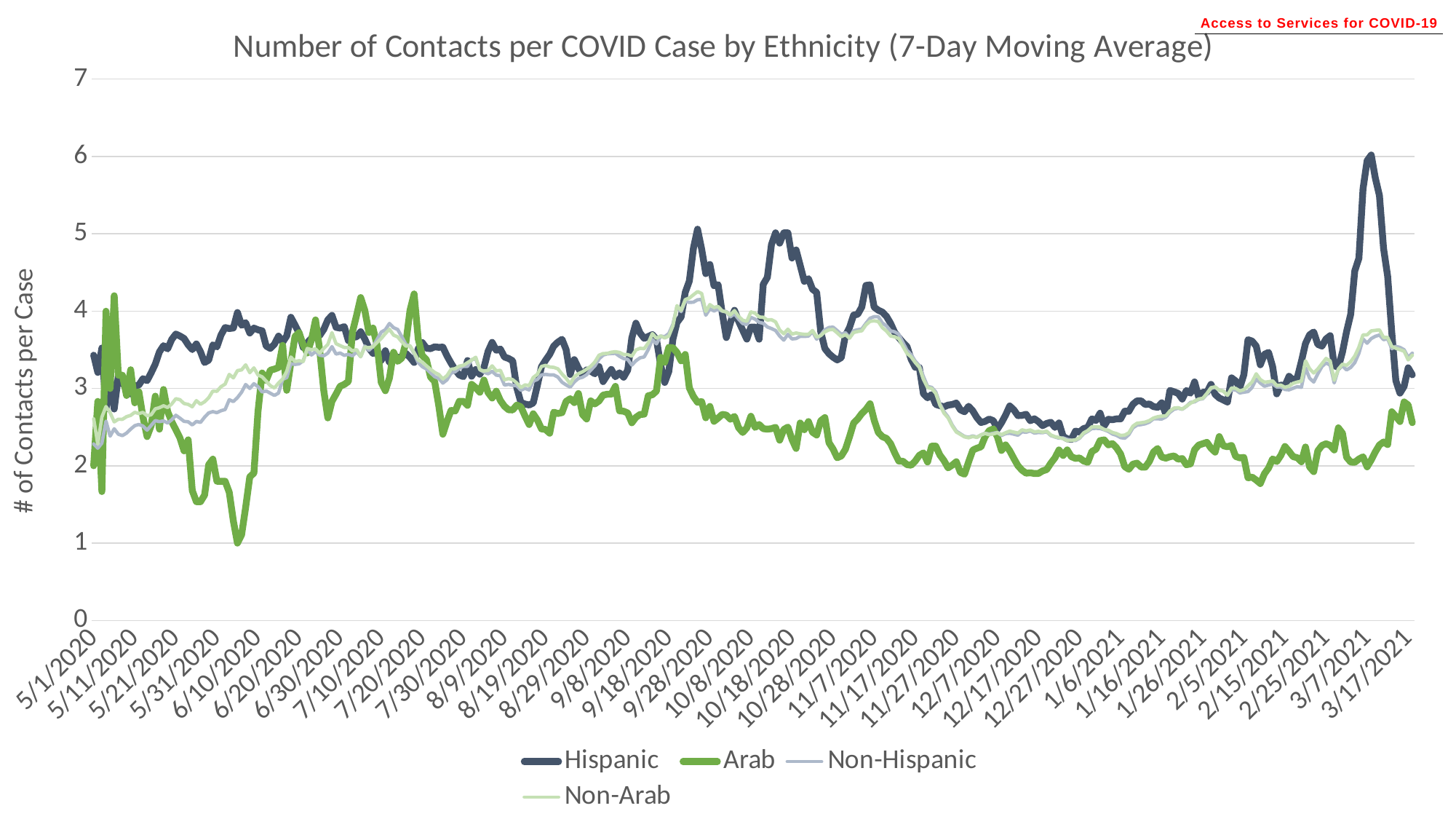
Is the lowest value of the Arab line around 6/10/2020 greater or less than 2? less What kind of chart is shown on the slide? Line chart What is the label on the vertical axis? # of Contacts per Case Does the Arab line generally rise or fall between 9/18/2020 and 12/17/2020? fall Which series has the lowest value around 12/17/2020? Arab Is the value of the Arab line around 12/17/2020 greater or less than 3? less How many series does the legend list? 4 What is the title of the chart? Number of Contacts per COVID Case by Ethnicity (7-Day Moving Average) Is the peak value of the Hispanic line around 3/7/2021 greater or less than 5? greater Around 10/28/2020, which is larger: the Hispanic line or the Arab line? Hispanic Which series reaches the highest value on the chart? Hispanic